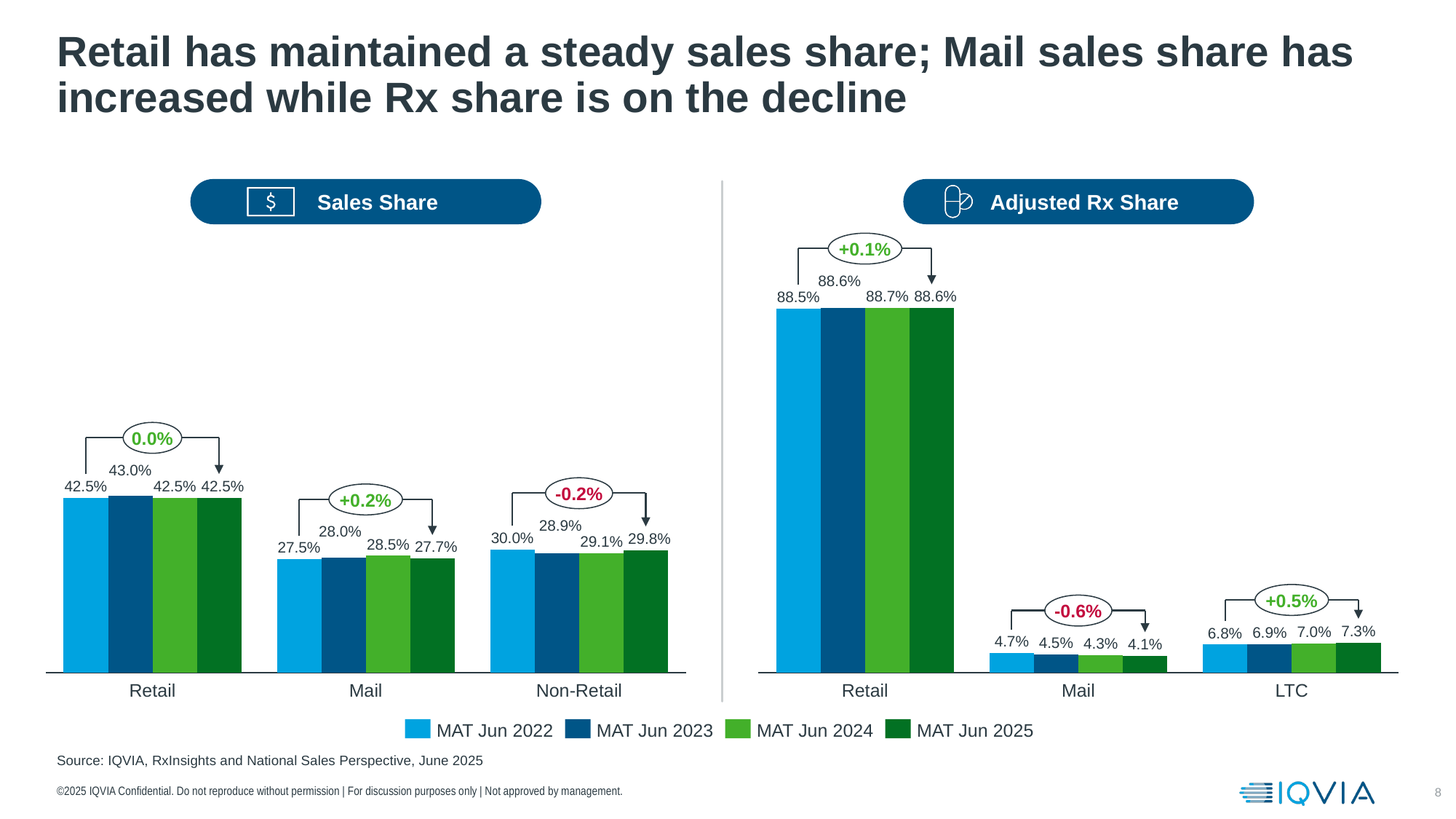
In the Adjusted Rx Share chart, what is the value for Mail in MAT Jun 2022? 4.7% In the Adjusted Rx Share chart, which category has the lowest value in MAT Jun 2025? Mail In the Sales Share chart, what is the difference between the Non-Retail value in MAT Jun 2022 and in MAT Jun 2024? 0.9% In the Sales Share chart, what is the value for Mail in MAT Jun 2025? 27.7% How many series does the legend list? 4 How many categories are shown on the x axis of the Adjusted Rx Share chart? 3 In the Sales Share chart, what is the value for Retail in MAT Jun 2023? 43.0% In the Adjusted Rx Share chart, is the LTC value in MAT Jun 2025 larger or smaller than the Mail value in MAT Jun 2025? larger In the Adjusted Rx Share chart, do the LTC values rise or fall from MAT Jun 2022 to MAT Jun 2025? Rise What kind of chart is the Sales Share chart? Bar chart In the Sales Share chart, which category has the highest value in MAT Jun 2025? Retail In the Adjusted Rx Share chart, what is the value for LTC in MAT Jun 2024? 7.0%